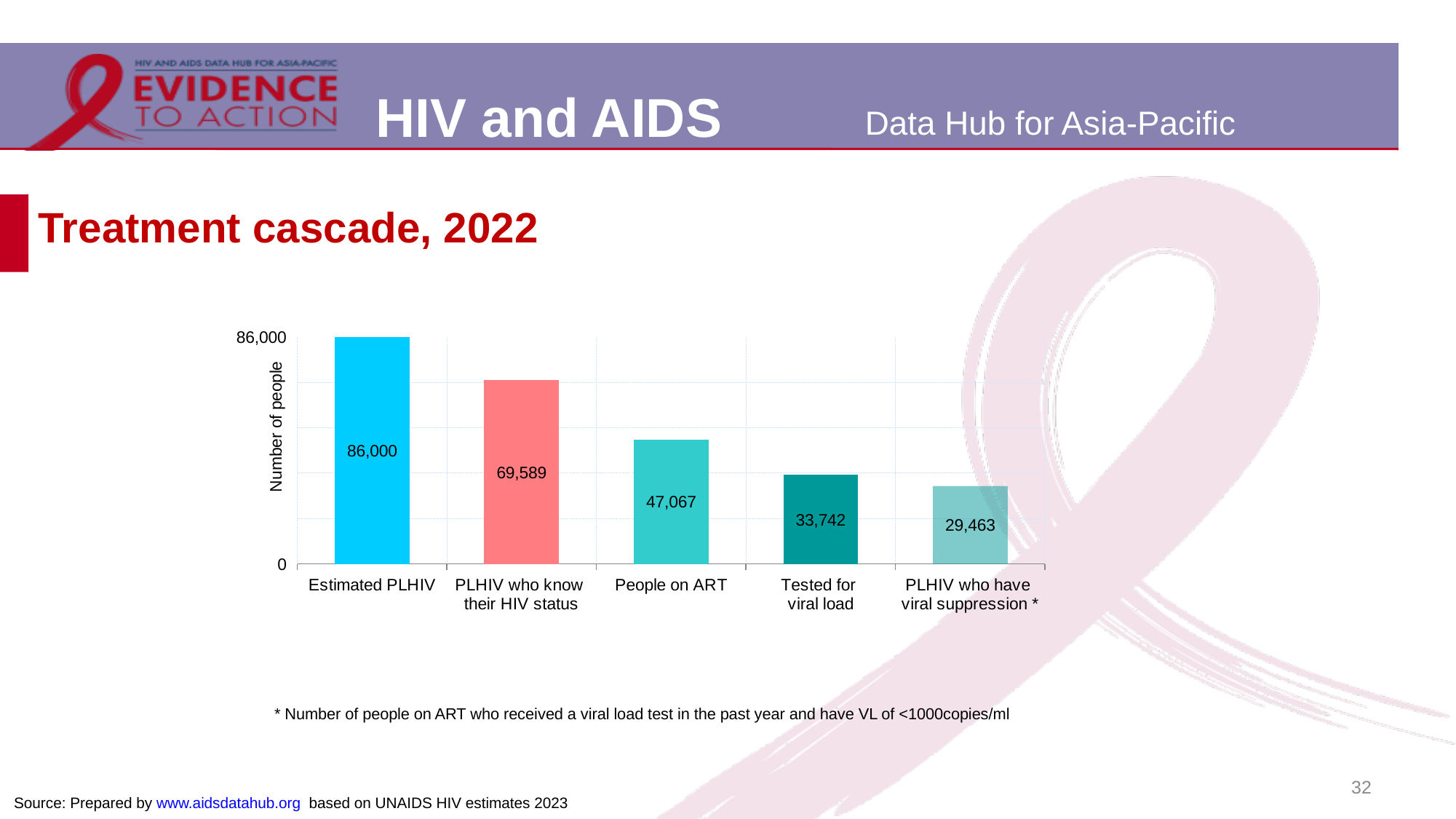
What is the value for PLHIV who have viral suppression? 29,463 What is the difference between Estimated PLHIV and PLHIV who know their HIV status? 16,411 What is the difference between People on ART and Tested for viral load? 13,325 What is the value for Estimated PLHIV? 86,000 Which category has the highest value? Estimated PLHIV What is the value for People on ART? 47,067 Which is larger, People on ART or PLHIV who have viral suppression? People on ART Do the values rise or fall from left to right along the x axis? fall Which category has the lowest value? PLHIV who have viral suppression What is the value for PLHIV who know their HIV status? 69,589 What is the value for Tested for viral load? 33,742 How many categories are shown on the x axis? 5